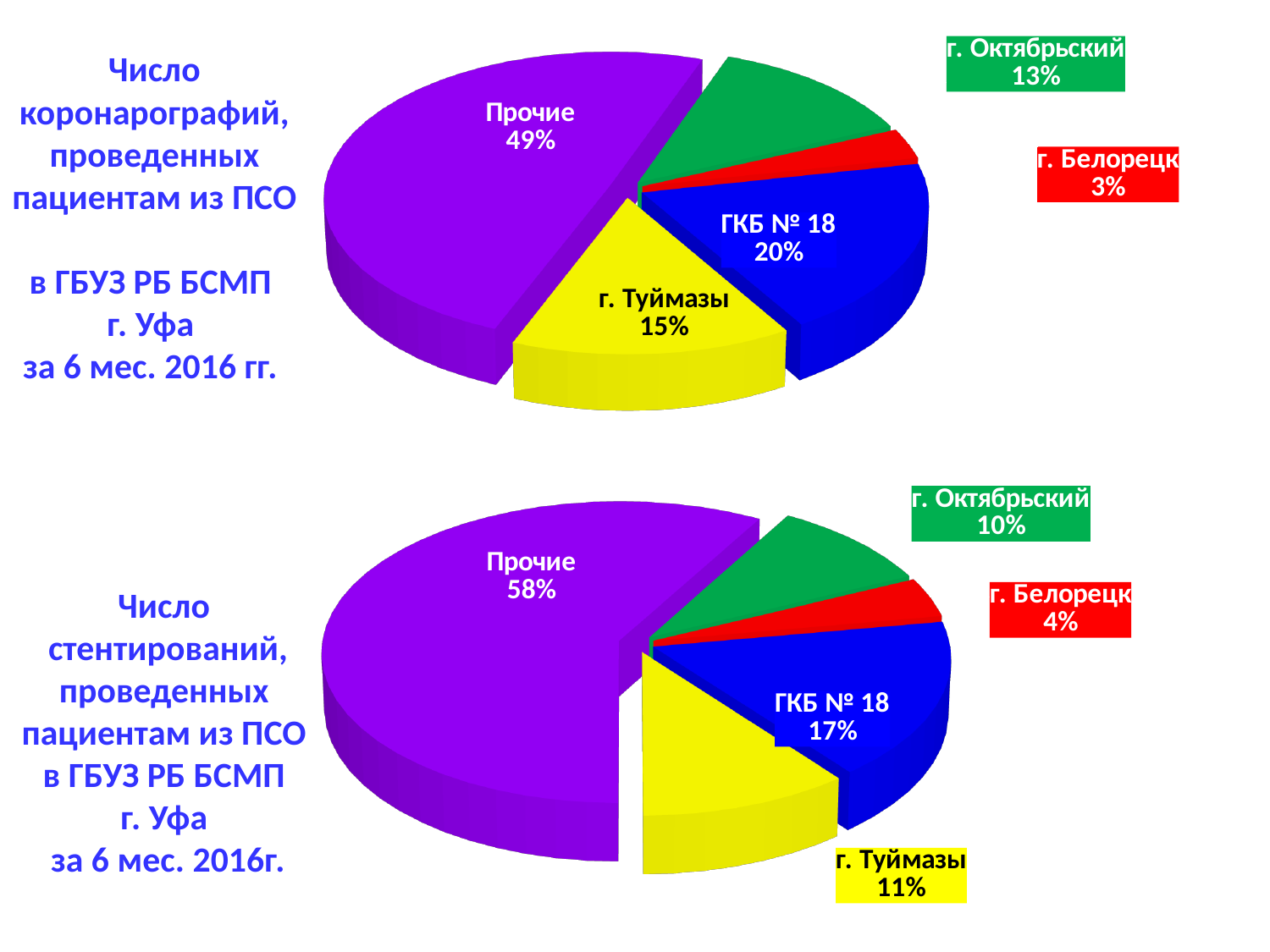
What type of chart is the bottom chart (Число стентирований)? Pie chart In the bottom chart (Число стентирований), what share does Прочие have? 58% In the bottom chart (Число стентирований), what share does г. Туймазы have? 11% In the bottom chart (Число стентирований), what colour is the г. Белорецк slice? Red In the top chart (Число коронарографий), what share does Прочие have? 49% In the top chart (Число коронарографий), which category has the smallest share? г. Белорецк In the bottom chart (Число стентирований), which is larger: the share of ГКБ № 18 or г. Октябрьский? ГКБ № 18 In the top chart (Число коронарографий), what share does г. Белорецк have? 3% In the bottom chart (Число стентирований), which category has the largest share? Прочие In the top chart (Число коронарографий), what share does ГКБ № 18 have? 20% In the top chart (Число коронарографий), what is the difference between the shares of ГКБ № 18 and г. Туймазы? 5% In the top chart (Число коронарографий), how many slices does the pie have? 5